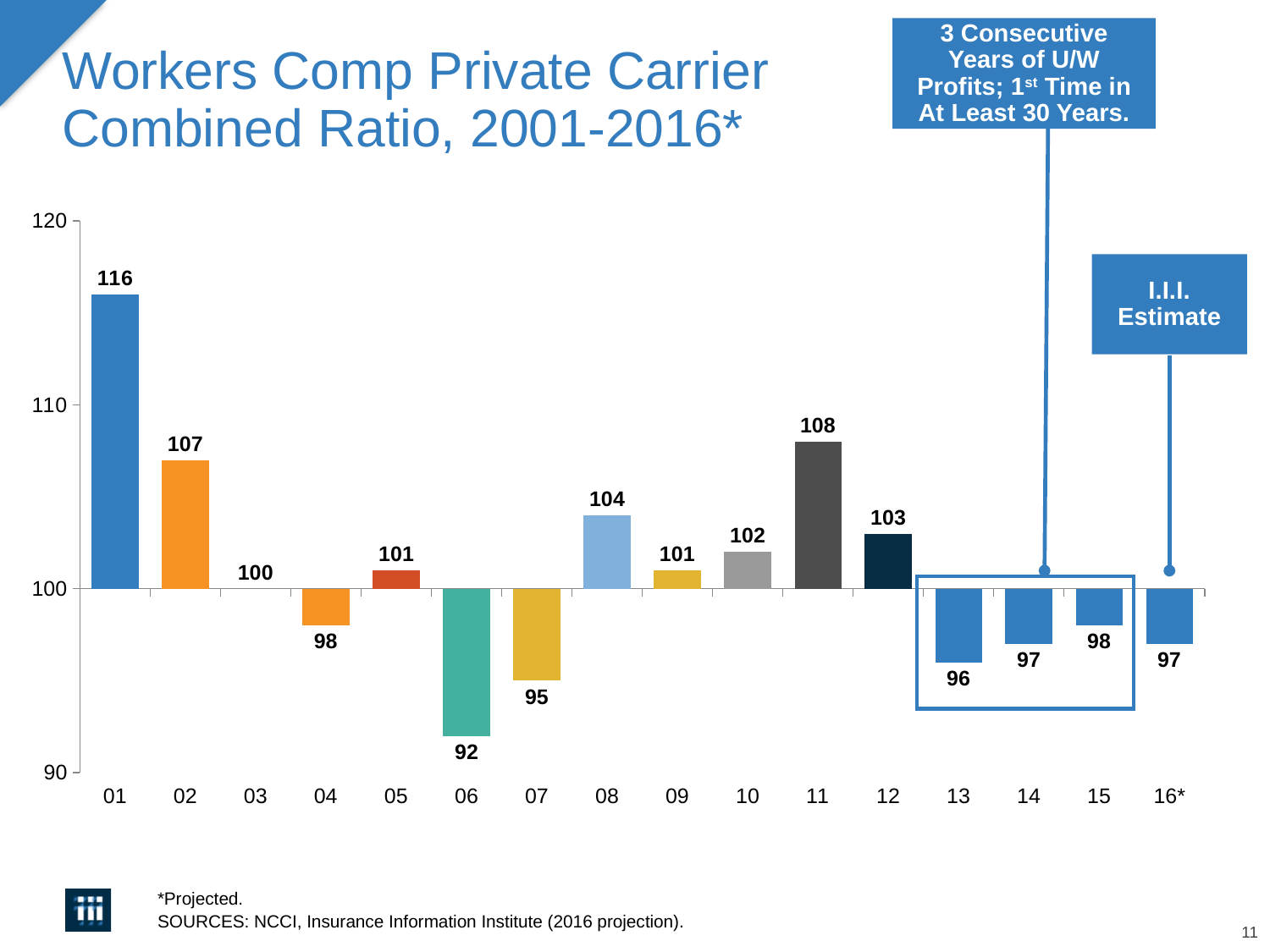
What is the title of the chart? Workers Comp Private Carrier Combined Ratio, 2001-2016* Is the combined ratio for 08 greater or less than 100? greater What is the combined ratio for 06? 92 Do the combined ratios rise or fall from 13 to 15? rise What kind of chart is this? bar chart What is the combined ratio for 01? 116 Which year has the lowest combined ratio? 06 What is the difference between the combined ratio for 01 and for 02? 9 Which year has the highest combined ratio? 01 How many years are shown on the x axis? 16 Which is larger, the combined ratio for 11 or for 12? 11 What is the combined ratio for 16*? 97